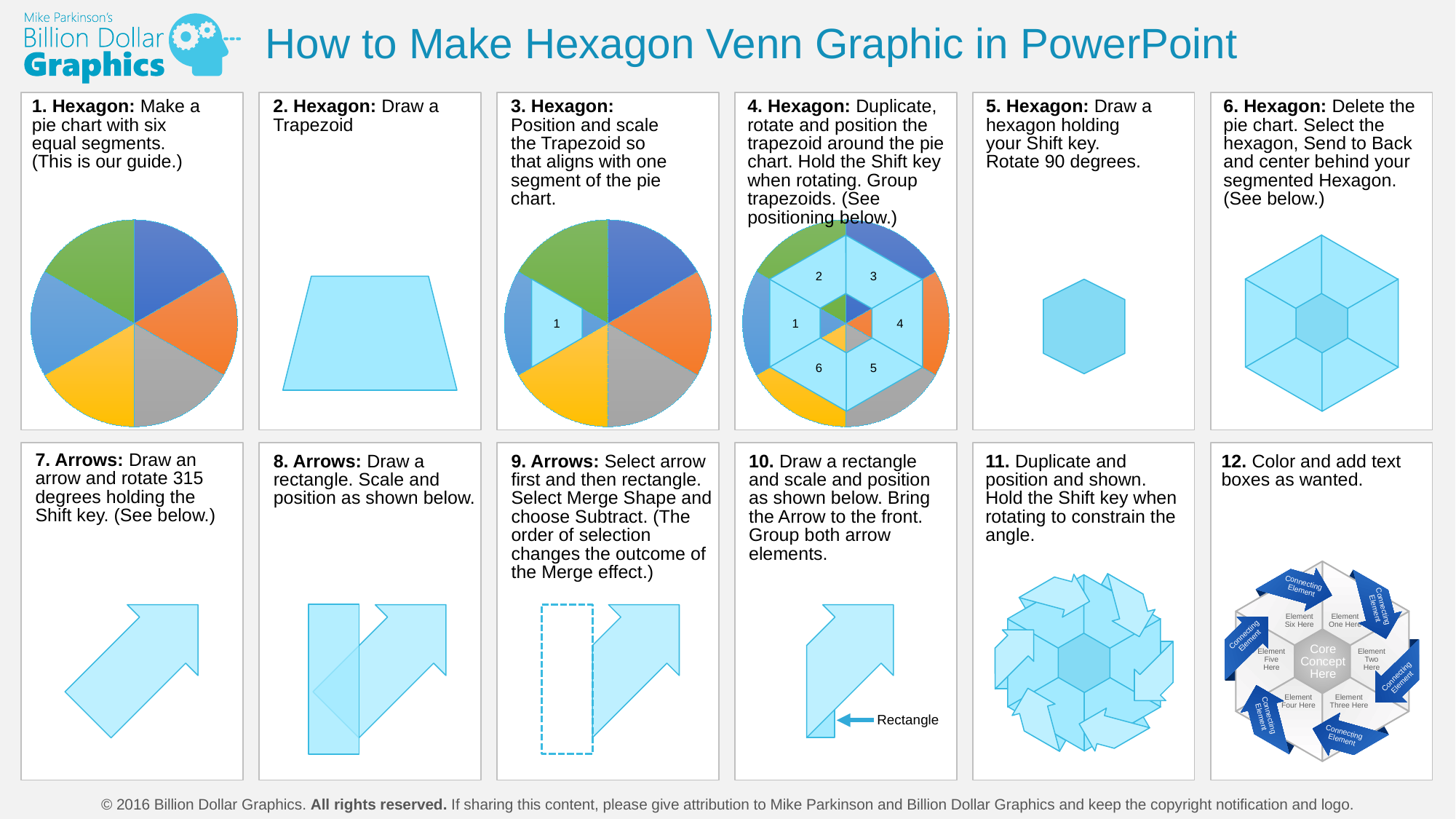
What kind of chart is shown in step 1 of the slide? pie chart How many segments does the pie chart in step 1 have? 6 According to the step 1 text, are the six segments of the pie chart equal or unequal in size? equal In step 3, how many trapezoids are placed over the pie chart? 1 In step 4, what number is printed on the trapezoid at the bottom right of the pie chart? 5 In step 4, how many numbered trapezoids are positioned around the pie chart? 6 In step 4, what number is printed on the trapezoid at the far left of the pie chart? 1 What colour is the top-right segment of the pie chart in step 1? blue Does the pie chart in step 1 show any data labels or percentages on its segments? no